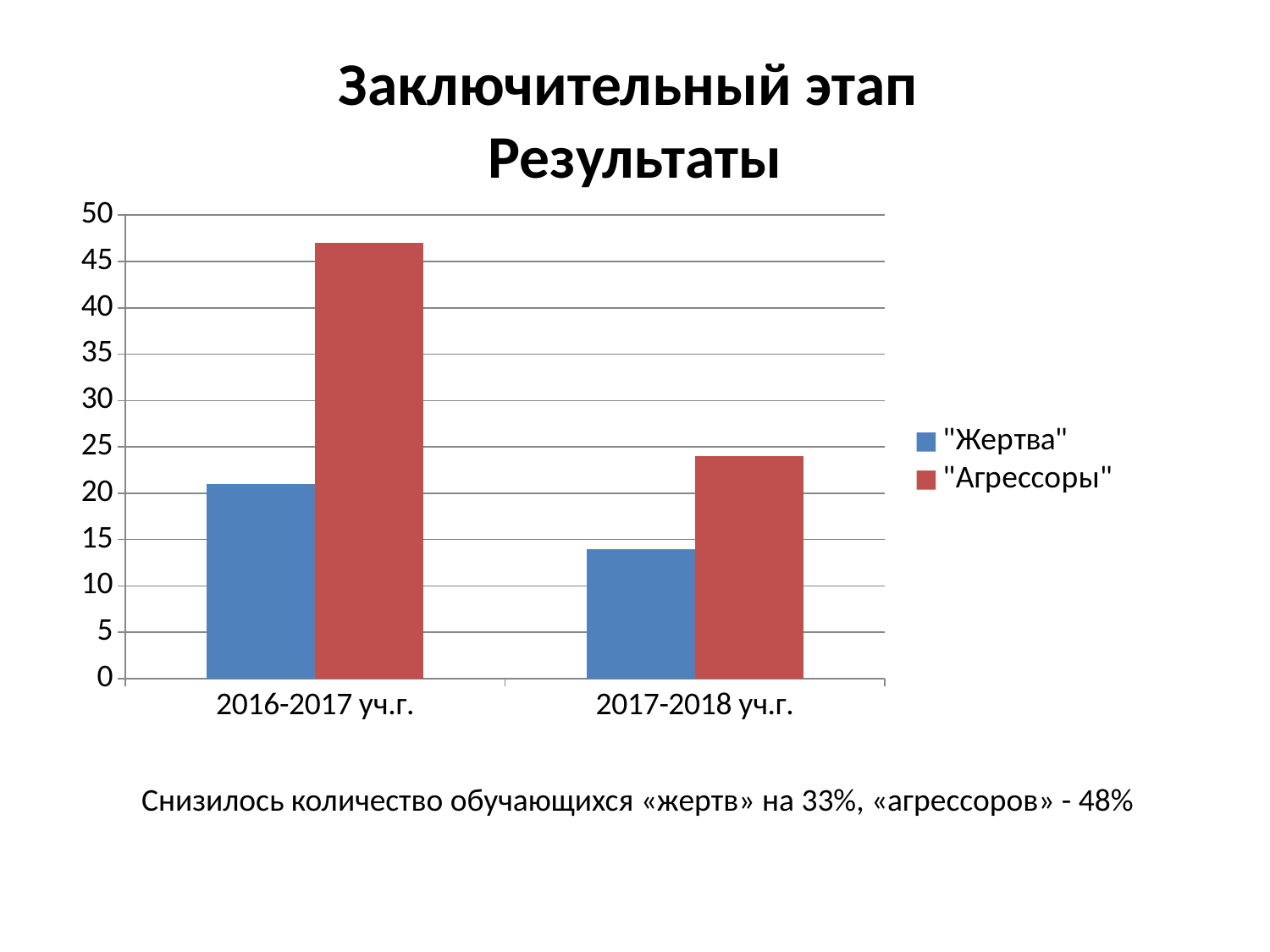
Is the value for "Жертва" in 2017-2018 уч.г. greater or less than 20? less Is the value for "Агрессоры" in 2016-2017 уч.г. greater or less than 45? greater Do the values for "Жертва" rise or fall from 2016-2017 уч.г. to 2017-2018 уч.г.? fall What kind of chart is shown on the slide? bar chart Which category has the lowest bar for "Жертва"? 2017-2018 уч.г. Is the value for "Агрессоры" in 2017-2018 уч.г. greater or less than 30? less What colour are the bars for the "Агрессоры" series? red Which is larger: "Агрессоры" in 2016-2017 уч.г. or "Агрессоры" in 2017-2018 уч.г.? "Агрессоры" in 2016-2017 уч.г. Which is larger in 2017-2018 уч.г.: "Жертва" or "Агрессоры"? "Агрессоры" How many categories are shown on the x axis? 2 Which series has the highest bar on the chart? "Агрессоры" How many series does the legend list? 2